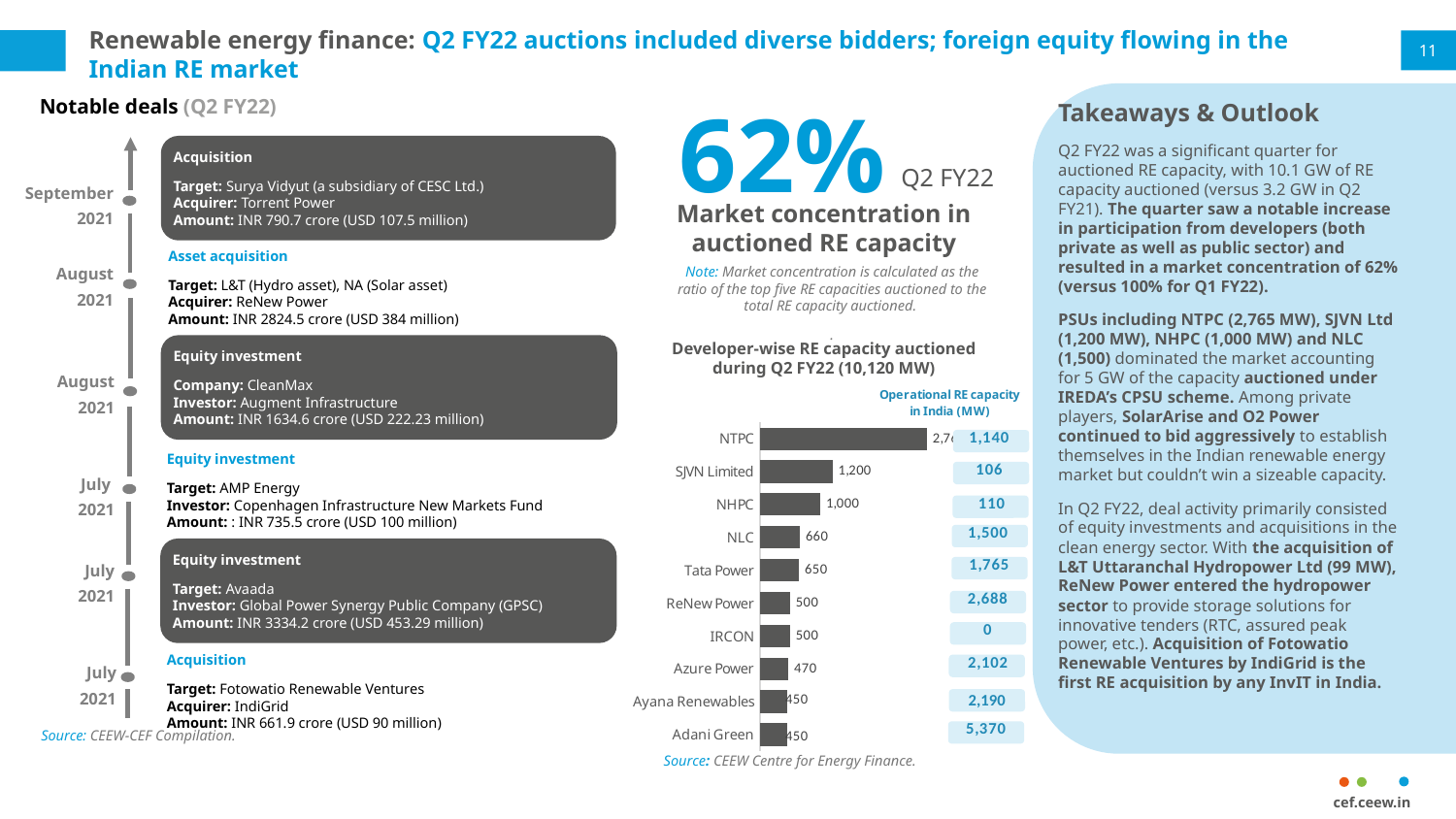
What is the RE capacity auctioned for SJVN Limited in the chart? 1,200 What is the RE capacity auctioned for Tata Power in the chart? 650 What is the difference between the RE capacity auctioned for SJVN Limited and NHPC? 200 Which developer has the highest RE capacity auctioned during Q2 FY22 in the chart? NTPC What kind of chart is used to show developer-wise RE capacity auctioned during Q2 FY22? Bar chart Which has a larger RE capacity auctioned in the chart, NLC or Tata Power? NLC Which has a larger RE capacity auctioned in the chart, SJVN Limited or ReNew Power? SJVN Limited According to the chart title, what is the total RE capacity auctioned during Q2 FY22? 10,120 MW What is the RE capacity auctioned for NHPC in the chart? 1,000 What is the RE capacity auctioned for Azure Power in the chart? 470 What is the RE capacity auctioned for NLC in the chart? 660 How many developers are listed in the developer-wise RE capacity auctioned chart? 10